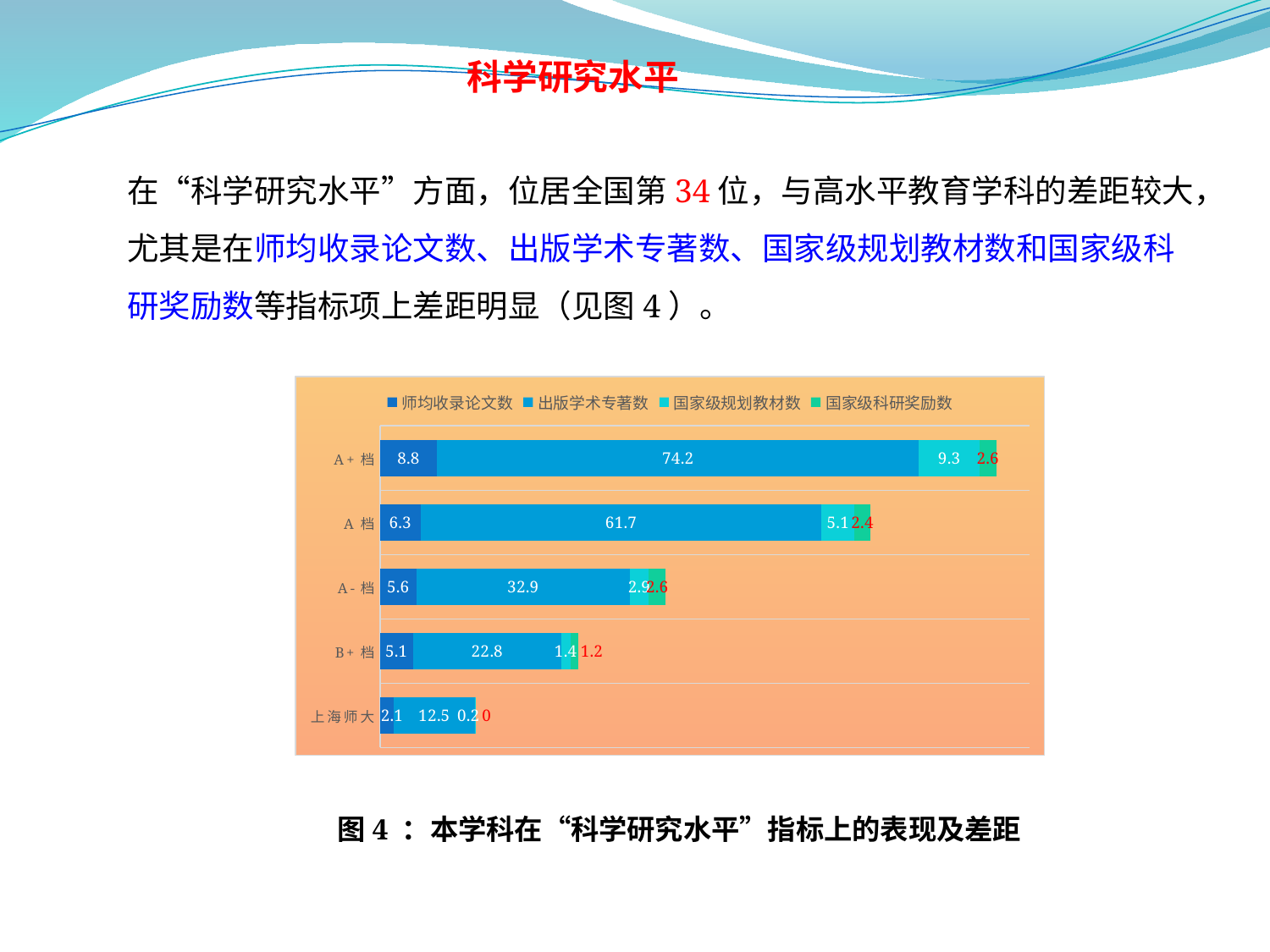
Which category has the highest 出版学术专著数 value? A+档 What is the 师均收录论文数 value for 上海师大? 2.1 How many categories are shown on the y axis? 5 How many series does the legend list? 4 What kind of chart is shown? Stacked bar chart What is the 出版学术专著数 value for A+档? 74.2 What is the 国家级规划教材数 value for A档? 5.1 What is the 国家级科研奖励数 value for B+档? 1.2 Which category has the lowest 国家级科研奖励数 value? 上海师大 What is the difference between the 出版学术专著数 values for A+档 and A档? 12.5 What is the total of the stacked bar for 上海师大? 14.8 Which is larger, the 师均收录论文数 value for A-档 or for B+档? A-档